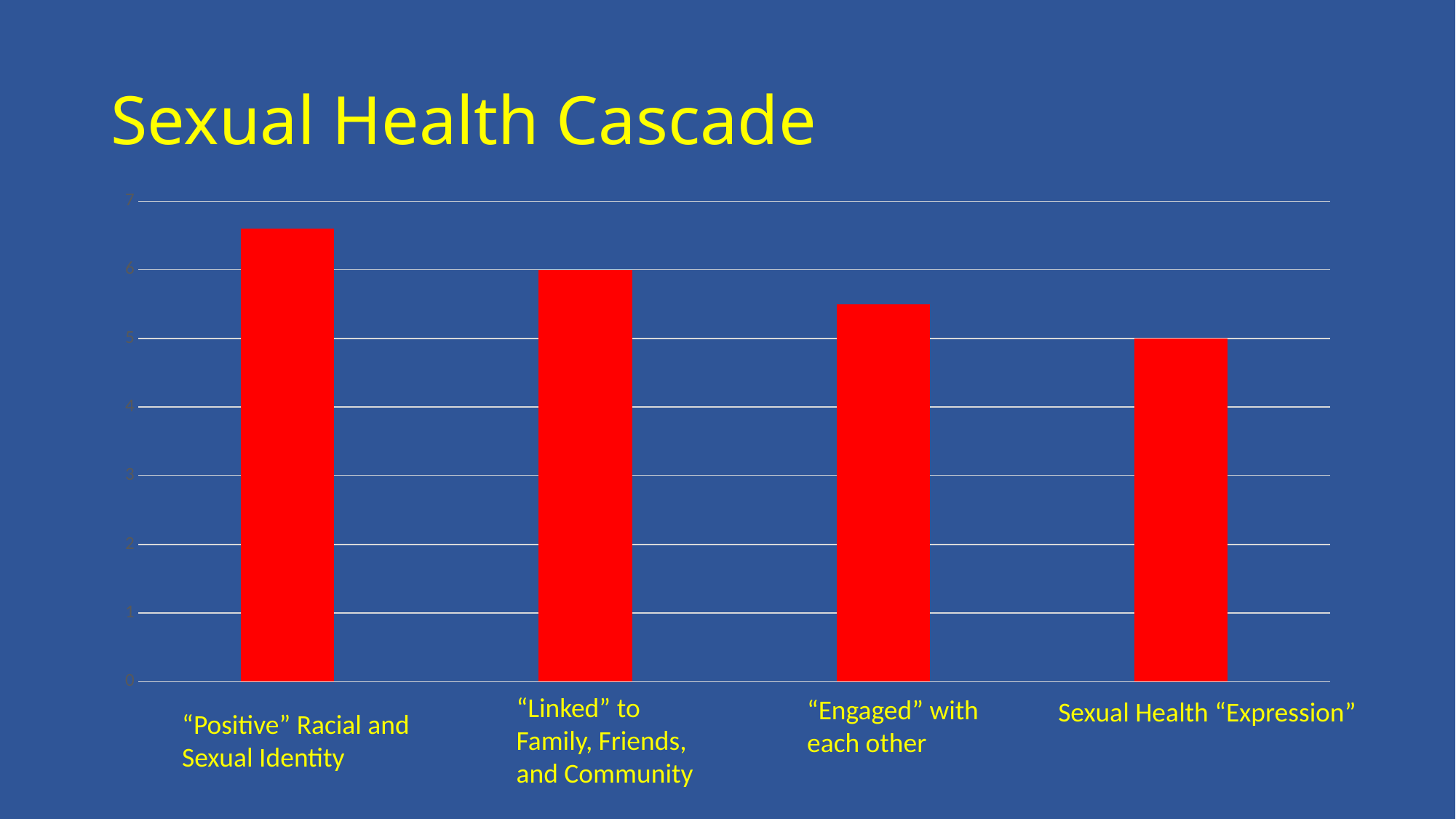
What is the value for Sexual Health "Expression"? 5 What kind of chart is shown on the slide? bar chart How many categories are plotted in the chart? 4 Is the value for "Engaged" with each other greater or less than 5? greater Which category has the lowest bar? Sexual Health "Expression" What colour are the bars in the chart? red Which is larger: the value for "Linked" to Family, Friends, and Community or the value for "Engaged" with each other? "Linked" to Family, Friends, and Community Is the value for "Engaged" with each other greater or less than 6? less Is the value for "Positive" Racial and Sexual Identity greater or less than 6? greater Do the bar values rise or fall from left to right across the categories? fall What is the title of the slide containing the chart? Sexual Health Cascade Which category has the highest bar? "Positive" Racial and Sexual Identity